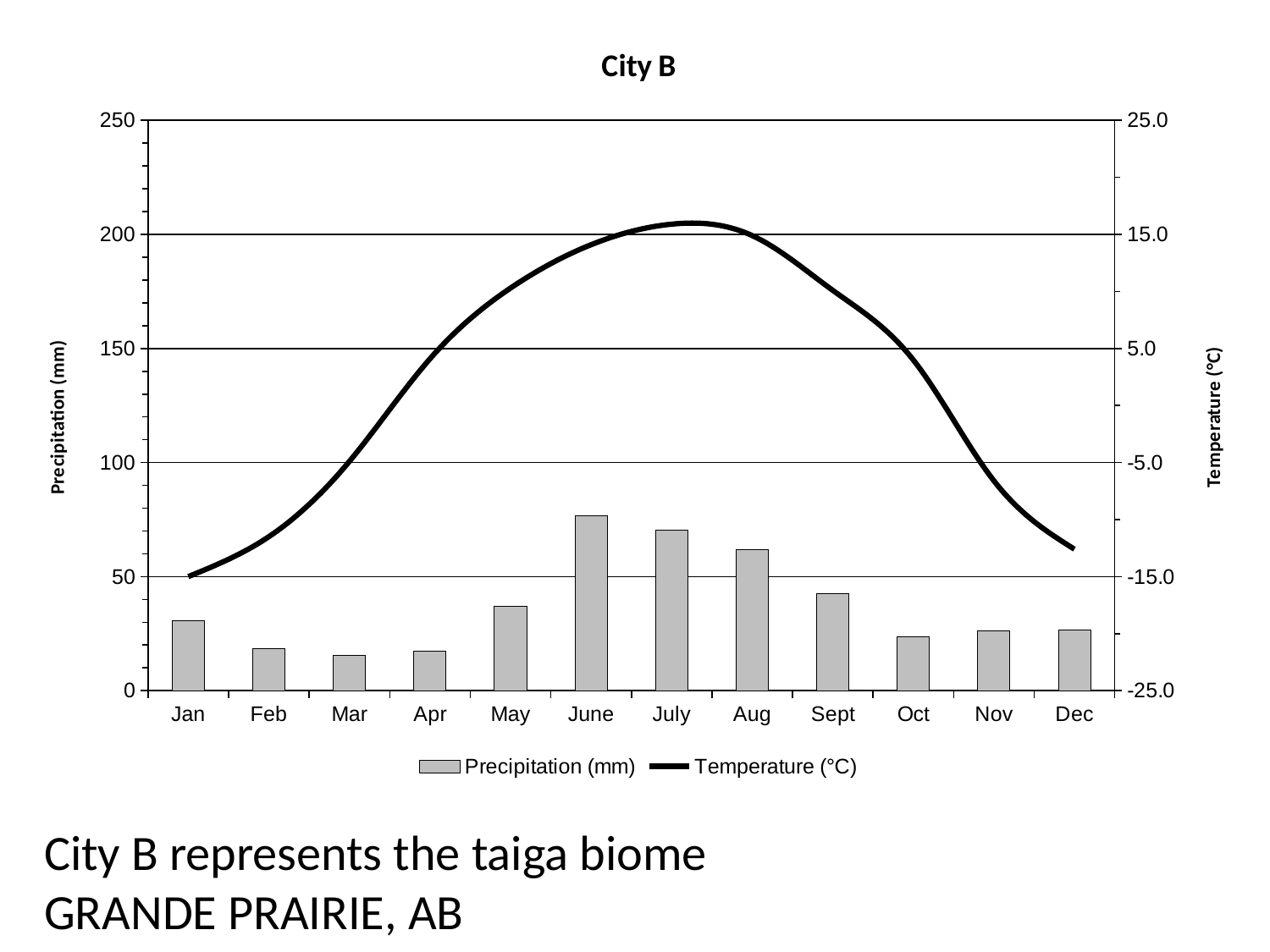
How many months are shown on the x axis? 12 Which month has the highest precipitation? June Which month has higher precipitation, Aug or Sept? Aug Is the temperature for July greater or less than 5.0 °C? greater How many series does the legend list? 2 What kind of chart is used for the Precipitation (mm) series? Bar chart Is the temperature for Jan greater or less than -5.0 °C? less What is the title of the chart? City B Is the precipitation for Feb greater or less than 50 mm? less Does the temperature rise or fall from Jan to July? rise What is the label on the left vertical axis? Precipitation (mm)